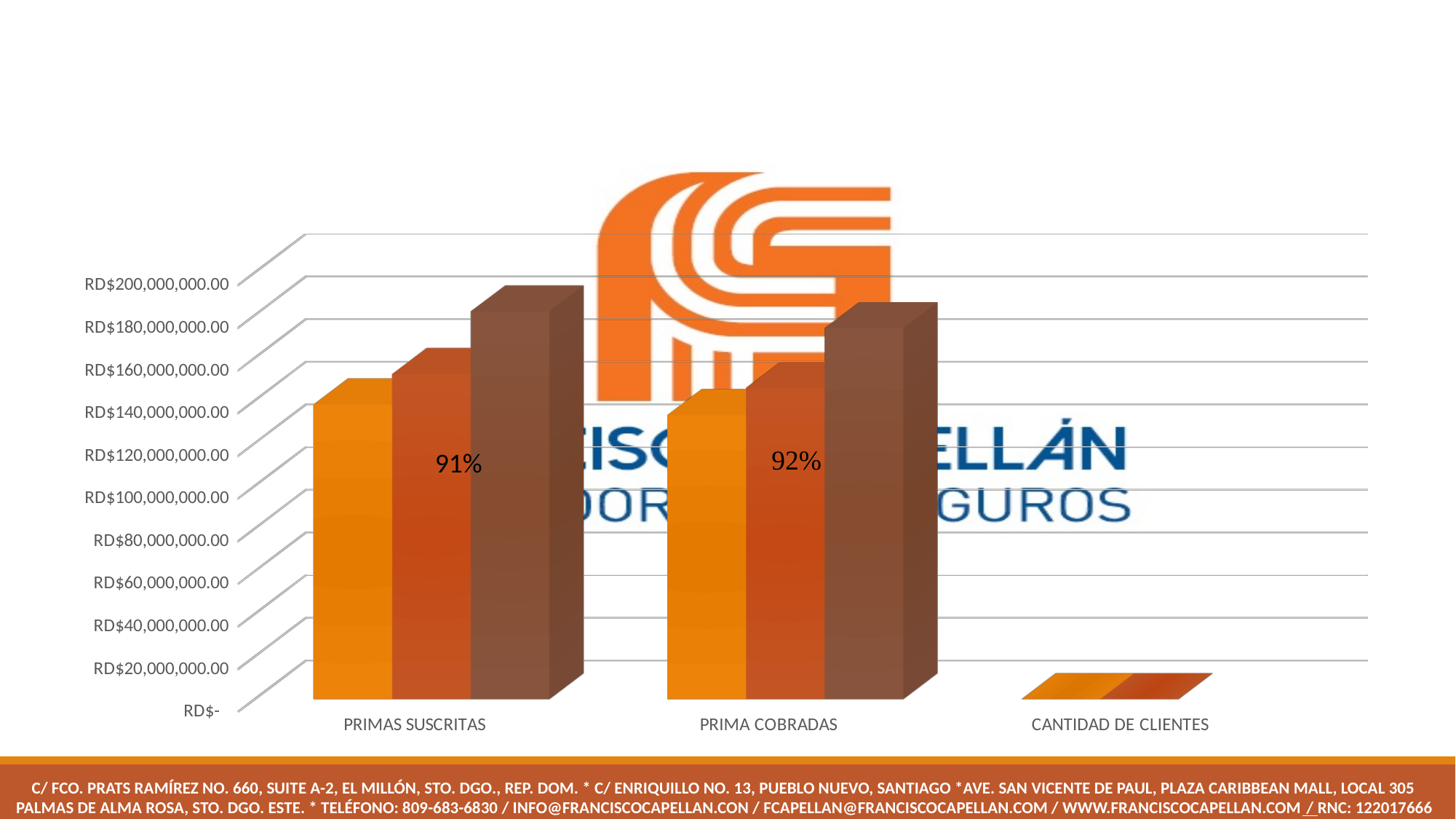
Which category has the tallest bar in the chart? PRIMAS SUSCRITAS Which is larger: the leftmost (light orange) bar for PRIMAS SUSCRITAS or the leftmost (light orange) bar for PRIMA COBRADAS? PRIMAS SUSCRITAS Are the bars for CANTIDAD DE CLIENTES greater or less than RD$20,000,000.00? less What type of chart is shown on the slide? bar chart Is the value of the rightmost (brown) bar for PRIMA COBRADAS greater or less than RD$160,000,000.00? greater What percentage label is displayed over the PRIMA COBRADAS bars? 92% How many categories are shown on the x axis of the chart? 3 Is the value of the rightmost (brown) bar for PRIMAS SUSCRITAS greater or less than RD$160,000,000.00? greater Which category has the lowest bars in the chart? CANTIDAD DE CLIENTES What percentage label is displayed over the PRIMAS SUSCRITAS bars? 91%